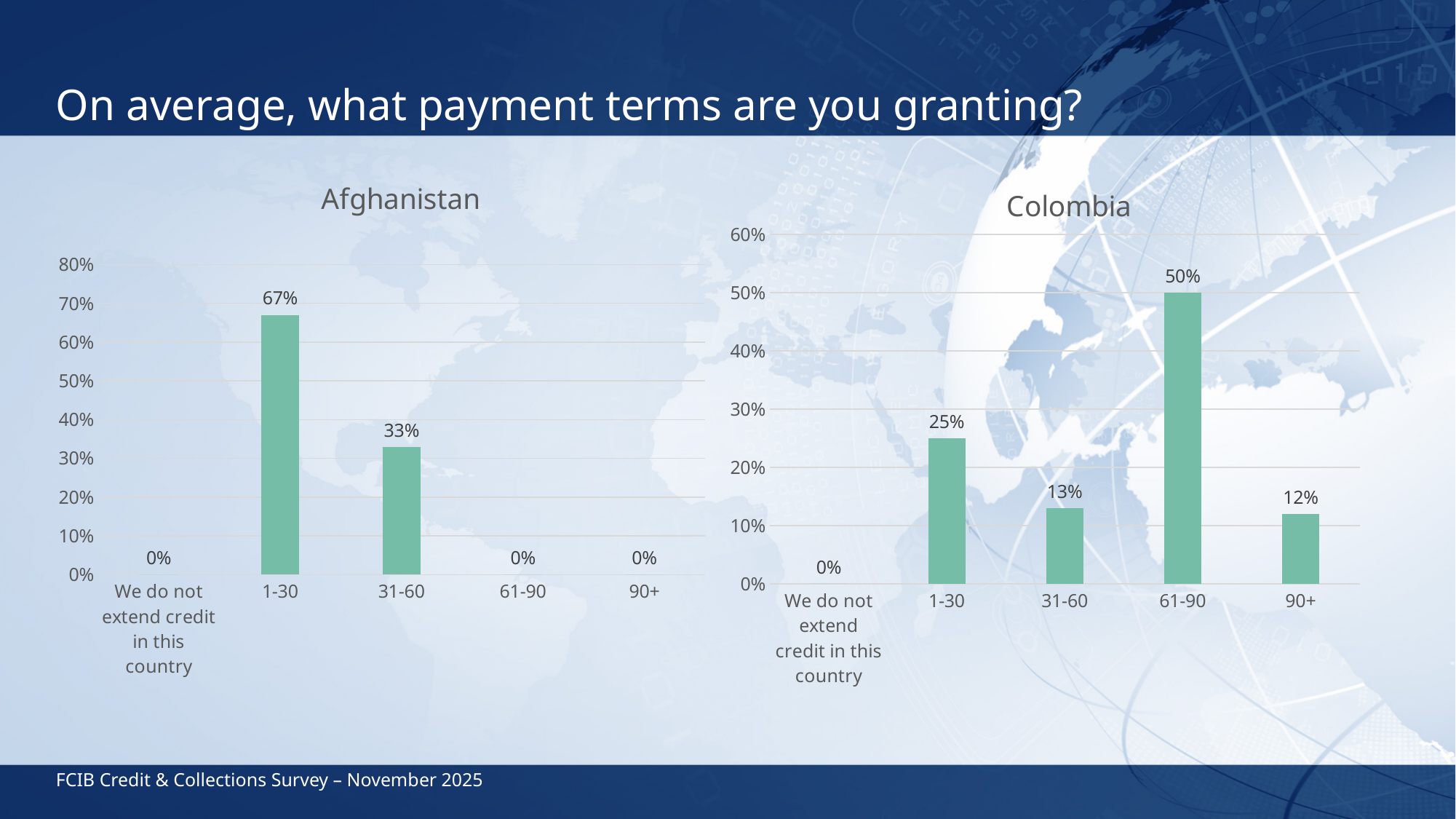
In the Afghanistan chart, what is the difference between the values for 1-30 and 31-60? 34% In the Afghanistan chart, what is the value for 31-60? 33% How many categories are shown on the x axis of the Colombia chart? 5 In the Afghanistan chart, what is the value for 1-30? 67% In the Colombia chart, what is the value for 61-90? 50% In the Afghanistan chart, how many categories have a value of 0%? 3 In the Colombia chart, which category has the highest value? 61-90 In the Colombia chart, what is the difference between the values for 61-90 and 1-30? 25% What kind of chart is the Afghanistan chart? Bar chart In the Afghanistan chart, which category has the highest value? 1-30 In the Colombia chart, which is larger, the value for 31-60 or the value for 90+? 31-60 In the Colombia chart, what is the value for 90+? 12%